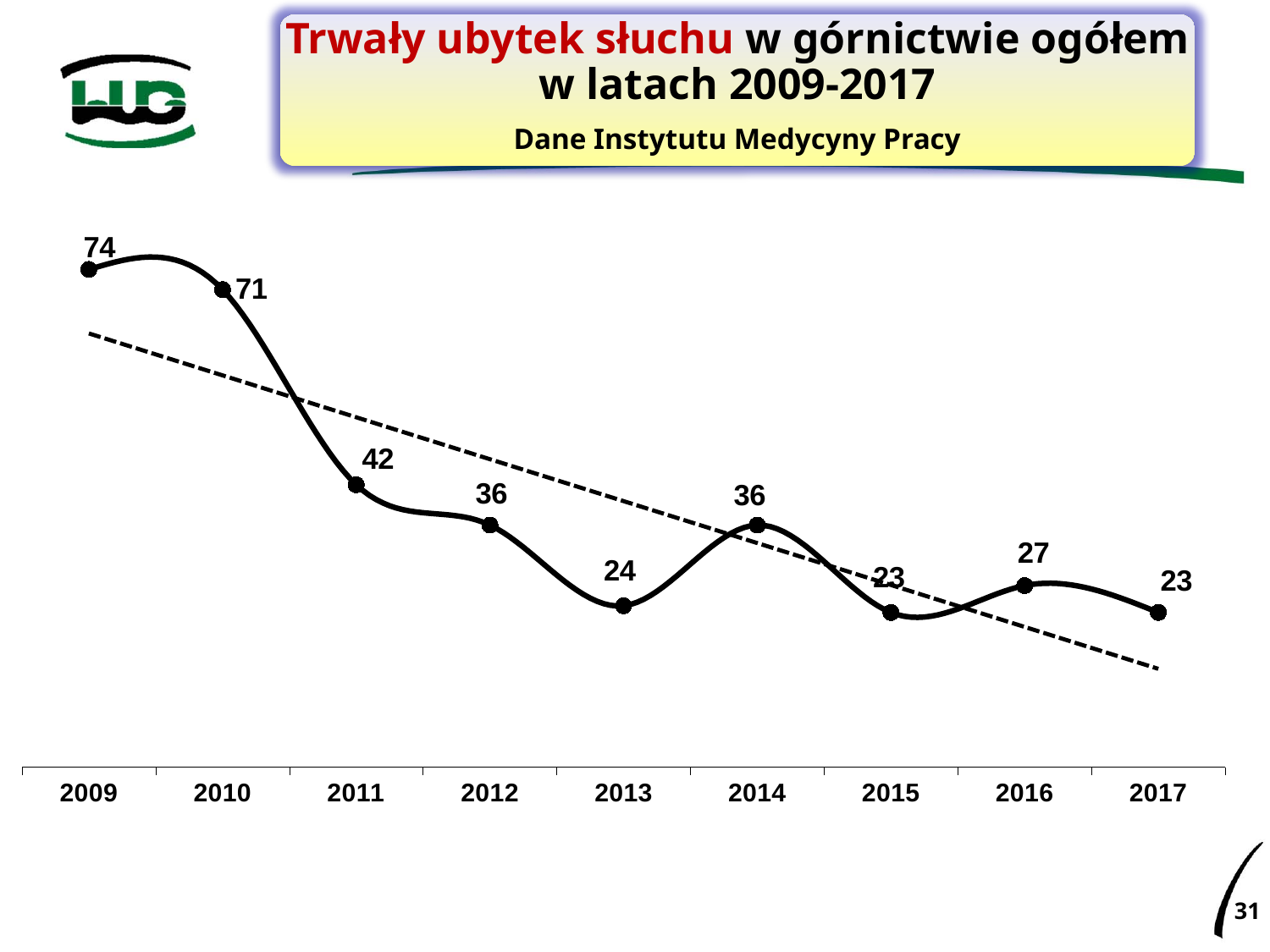
What is the value for 2016? 27 What kind of chart is shown on the slide? line chart Do the values generally rise or fall from 2009 to 2017? fall What is the value for 2011? 42 What is the lowest value shown on the chart? 23 What is the difference between the values for 2009 and 2017? 51 What is the value for 2009? 74 What is the value for 2013? 24 How many years are plotted on the x axis? 9 What is the difference between the values for 2010 and 2011? 29 Which is larger, the value for 2014 or the value for 2015? 2014 Which year has the highest value? 2009